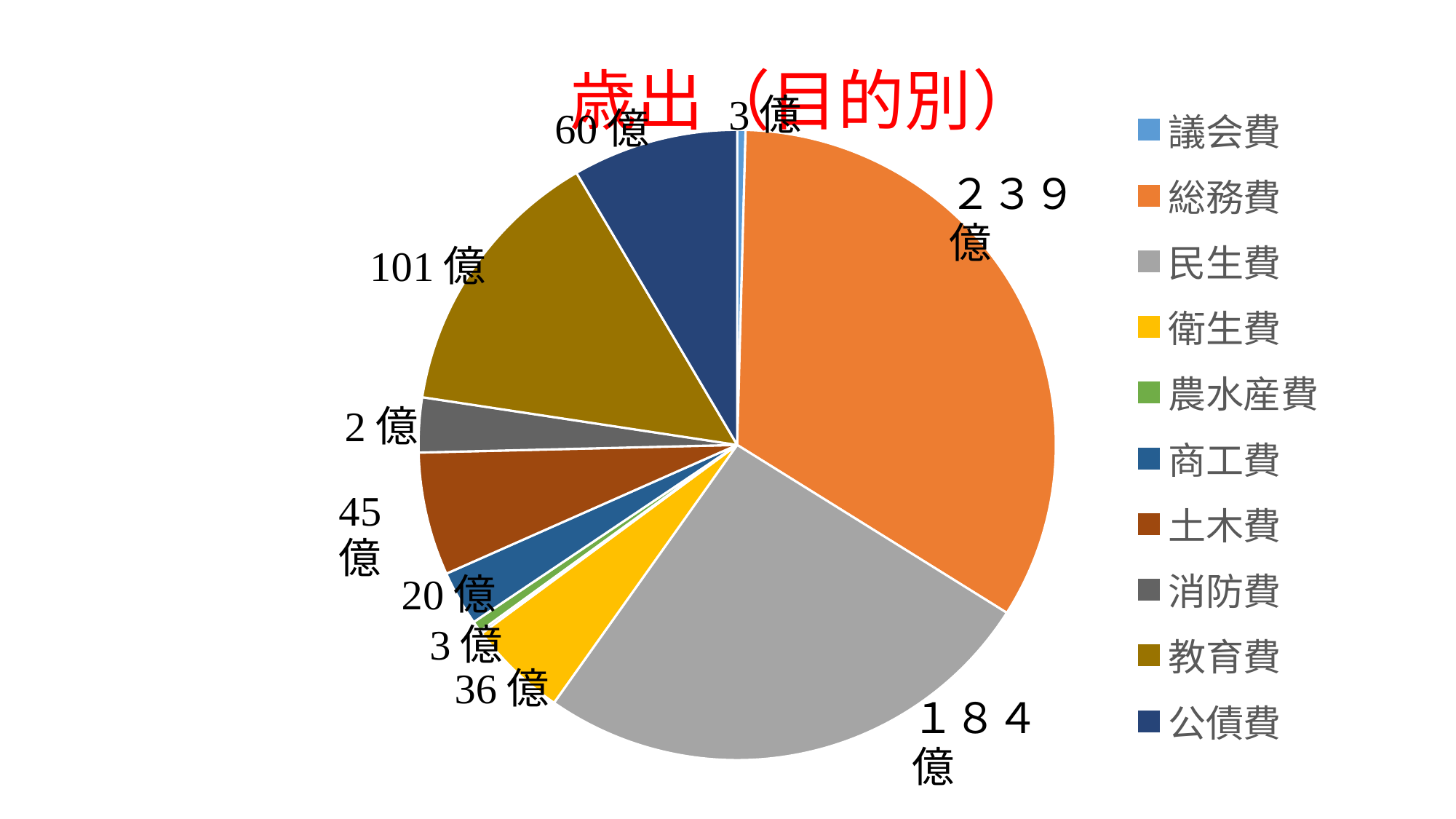
Which category has the largest slice? 総務費 What is the value for 教育費? 101 億 What colour is the 衛生費 slice? yellow What is the value for 民生費? １８４億 What is the title of the chart? 歳出（目的別） What is the value for 土木費? 45 億 Which is larger, 教育費 or 公債費? 教育費 What is the value for 総務費? ２３９億 What kind of chart is shown on the slide? pie chart What is the difference between 総務費 and 民生費? 55億 How many categories does the legend list? 10